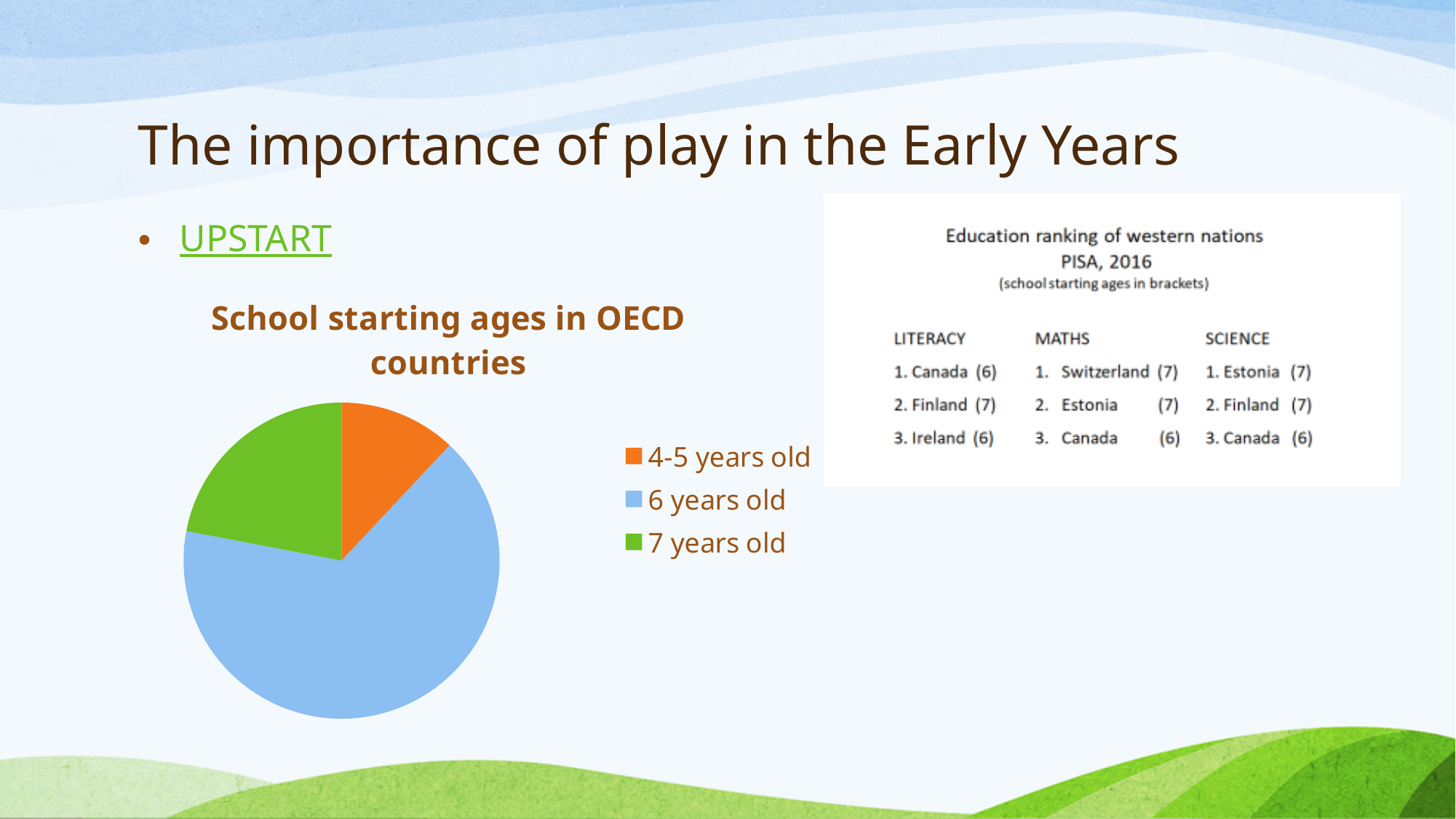
How many entries does the legend of the "School starting ages in OECD countries" chart list? 3 Which category has the smallest slice in the "School starting ages in OECD countries" pie chart? 4-5 years old In the "School starting ages in OECD countries" pie chart, which slice is larger: 4-5 years old or 7 years old? 7 years old In the "School starting ages in OECD countries" pie chart, which slice is larger: 6 years old or 7 years old? 6 years old What colour is the "6 years old" slice in the "School starting ages in OECD countries" pie chart? blue What is the title of the pie chart on the slide? School starting ages in OECD countries Which category has the largest slice in the "School starting ages in OECD countries" pie chart? 6 years old How many slices does the "School starting ages in OECD countries" pie chart have? 3 What kind of chart is "School starting ages in OECD countries"? pie chart